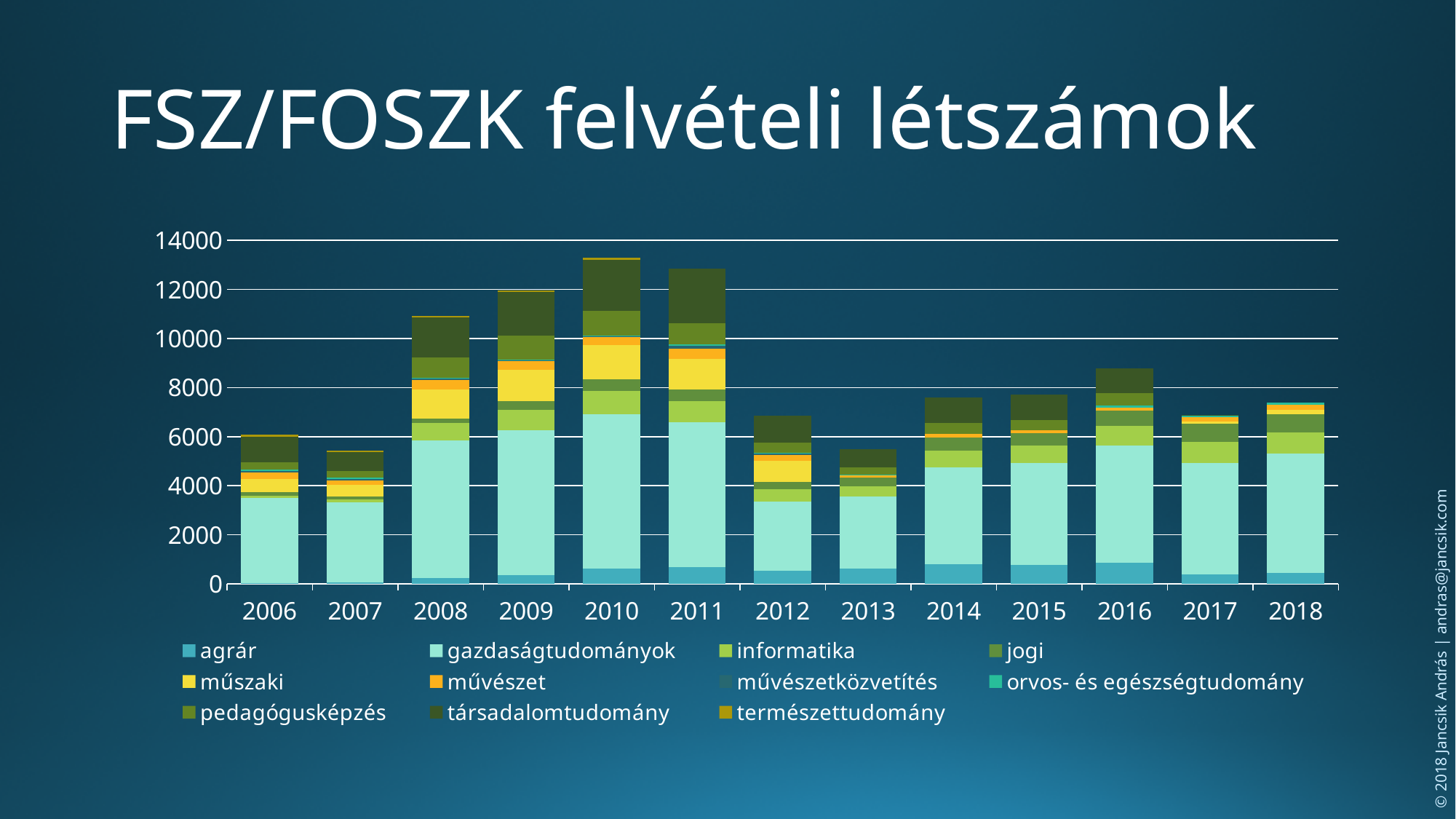
Is the total for 2007 greater or less than 6000? less Do the total bars rise or fall from 2011 to 2013? fall How many series does the legend list? 11 What kind of chart is shown on the slide? stacked bar chart Is the total for 2016 greater or less than 8000? greater Which year has the larger total bar, 2008 or 2009? 2009 Is the total for 2018 greater or less than 8000? less Which year has the larger total bar, 2014 or 2017? 2014 Which year has the highest total bar? 2010 How many years are shown on the x axis of the chart? 13 What is the title of the slide? FSZ/FOSZK felvételi létszámok